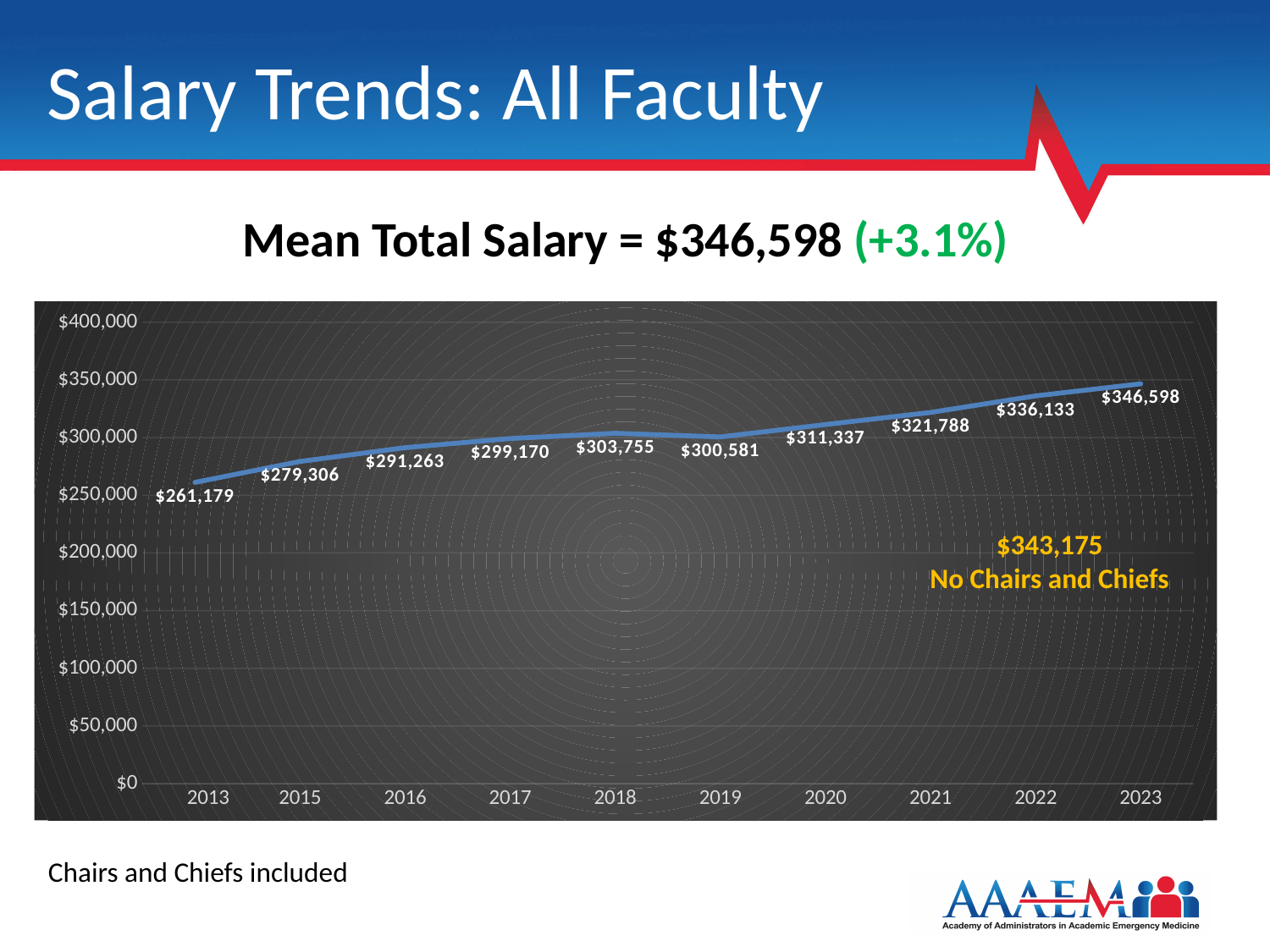
What is the overall trend of mean total salary from 2013 to 2023? Rising Which year has the lowest mean total salary? 2013 Which is larger, the mean total salary in 2018 or in 2019? 2018 What is the difference between the 2023 and 2022 mean total salaries? $10,465 What is the mean total salary for 2013? $261,179 How many years are plotted on the x axis? 10 What is the mean total salary for 2022? $336,133 What is the difference between the 2018 and 2019 mean total salaries? $3,174 What is the mean total salary for 2019? $300,581 What type of chart is shown on the slide? Line chart Which year has the highest mean total salary? 2023 Is the mean total salary for 2021 greater or less than $300,000? greater